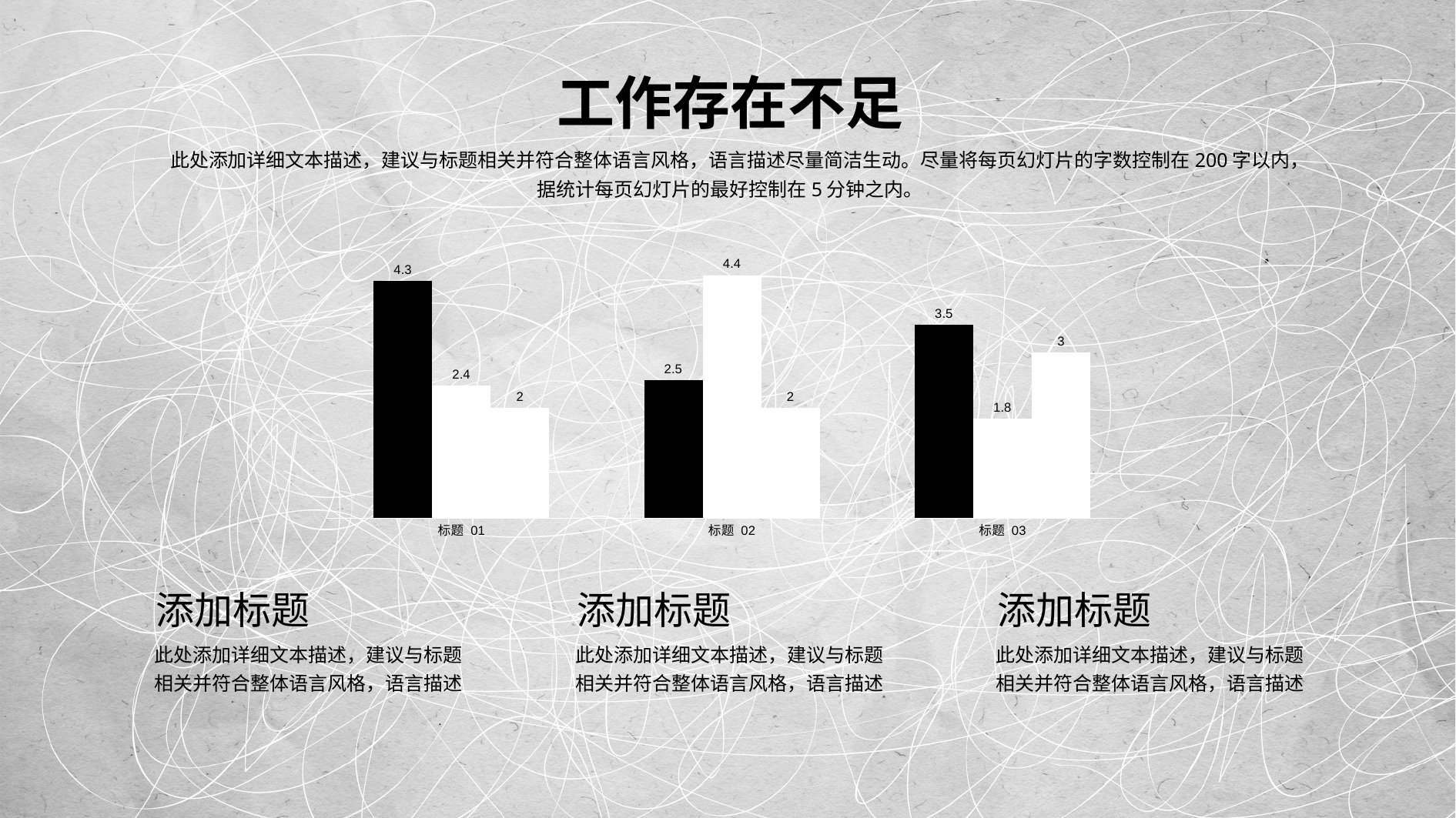
What is the value of the third bar for 标题 01? 2 Which category has the single highest bar in the chart? 标题 02 Which is larger: the black bar for 标题 01 or the black bar for 标题 03? 标题 01 What is the difference between the black bar for 标题 01 (4.3) and the black bar for 标题 02 (2.5)? 1.8 What is the value of the tallest bar for 标题 02? 4.4 What is the value of the black (first) bar for 标题 01? 4.3 Which category contains the lowest bar in the chart? 标题 03 What is the total of the three bars for 标题 03? 8.3 What kind of chart is shown on the slide? bar chart What is the value of the black (first) bar for 标题 03? 3.5 How many categories are shown on the x axis of the chart? 3 What is the value of the second bar for 标题 03? 1.8